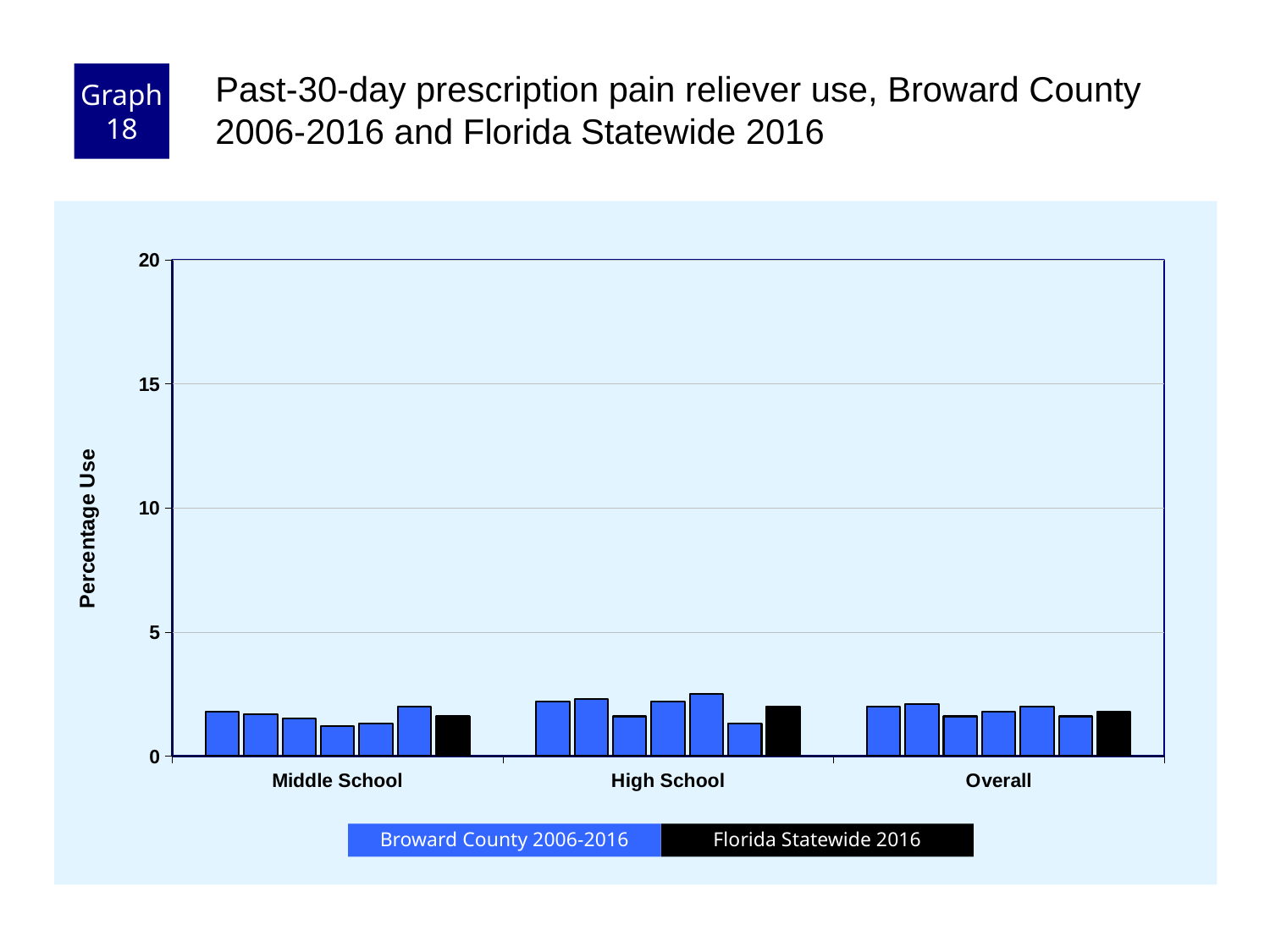
What is the maximum value shown on the y axis? 20 Are any of the Broward County 2006-2016 bars for High School greater or less than 5? less Is the Florida Statewide 2016 value for Overall greater or less than 10? less Is the highest Broward County 2006-2016 bar for Overall greater or less than 5? less What is the title of the chart? Past-30-day prescription pain reliever use, Broward County 2006-2016 and Florida Statewide 2016 What kind of chart is shown on the slide? bar chart What is the label on the y axis? Percentage Use How many school-level categories are shown on the x axis? 3 How many series does the legend list? 2